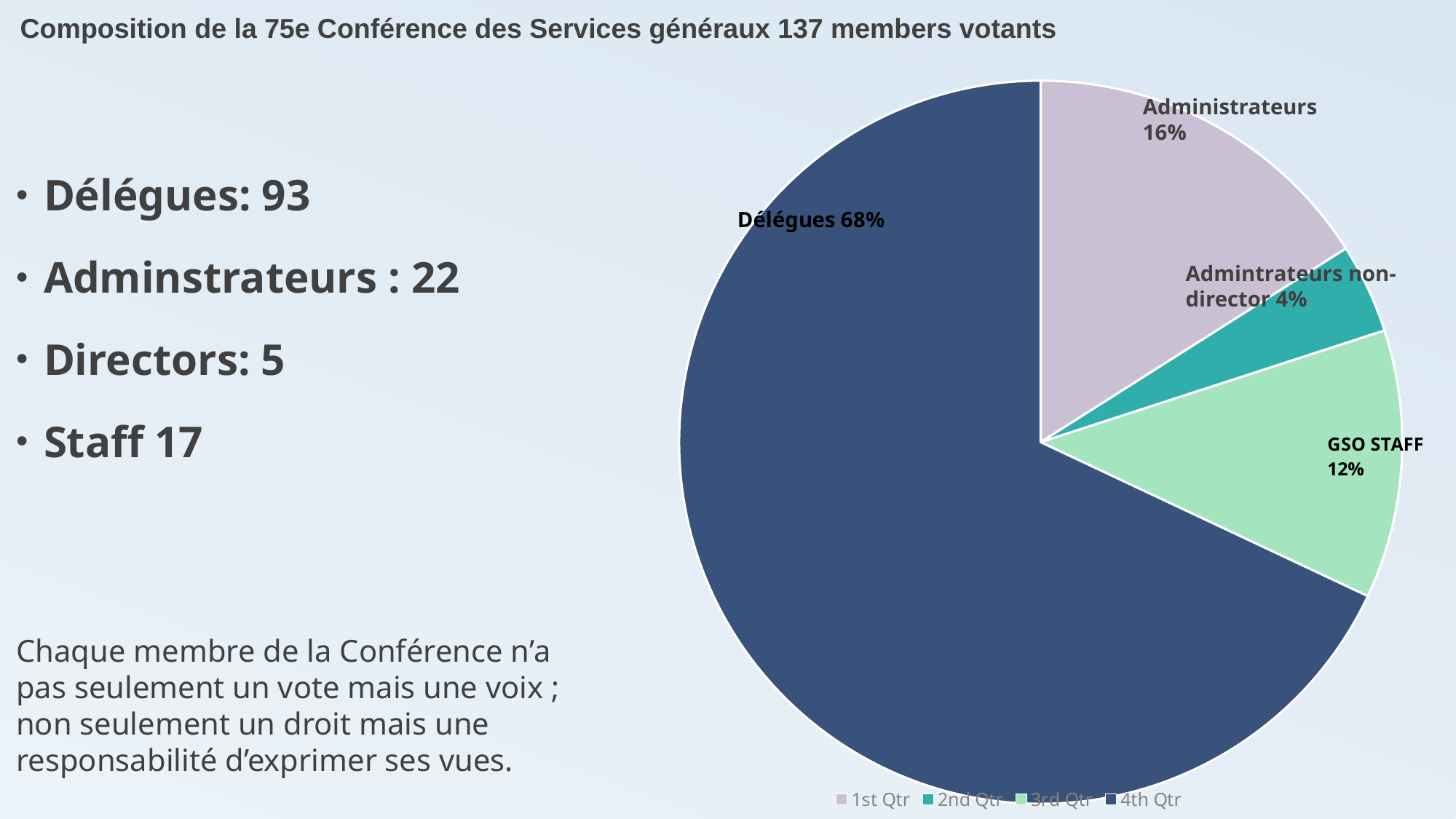
What are the entries listed in the chart legend? 1st Qtr, 2nd Qtr, 3rd Qtr, 4th Qtr What percentage of the pie is labelled Délégues? 68% Which slice of the pie chart is the smallest? Admintrateurs non-director What percentage of the pie is labelled GSO STAFF? 12% How many slices does the pie chart have? 4 What kind of chart is shown on the slide? pie chart Which slice is larger, Administrateurs or GSO STAFF? Administrateurs What percentage of the pie is labelled Administrateurs? 16% How many entries does the chart legend list? 4 What is the difference in percentage points between the Délégues slice and the Administrateurs slice? 52 What percentage of the pie is labelled Admintrateurs non-director? 4% Which slice of the pie chart is the largest? Délégues